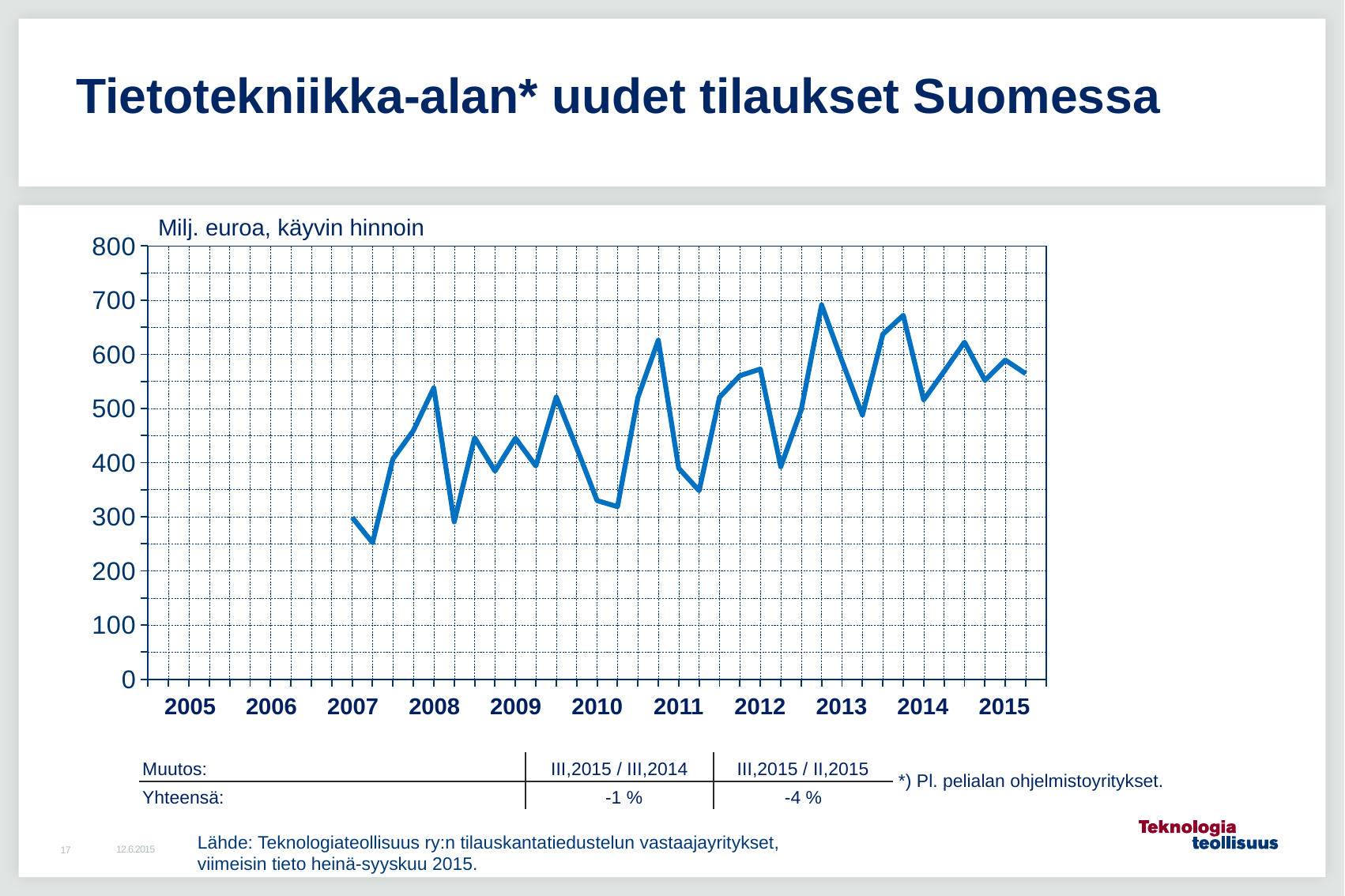
What unit label is printed above the y axis of the chart? Milj. euroa, käyvin hinnoin Which is larger: the value at the start of 2008 or the value at the start of 2010? start of 2008 In which year does the line reach its lowest point? 2007 What is the title of the chart on the slide? Tietotekniikka-alan* uudet tilaukset Suomessa What kind of chart is shown on the slide? line chart Overall, do the values rise or fall from 2007 to 2015? rise How many year labels are shown on the x axis of the chart? 11 Is the last plotted value in 2015 greater or less than 500? greater In which year does the line reach its highest point? 2013 Is the lowest value of the line in 2007 greater or less than 300? less